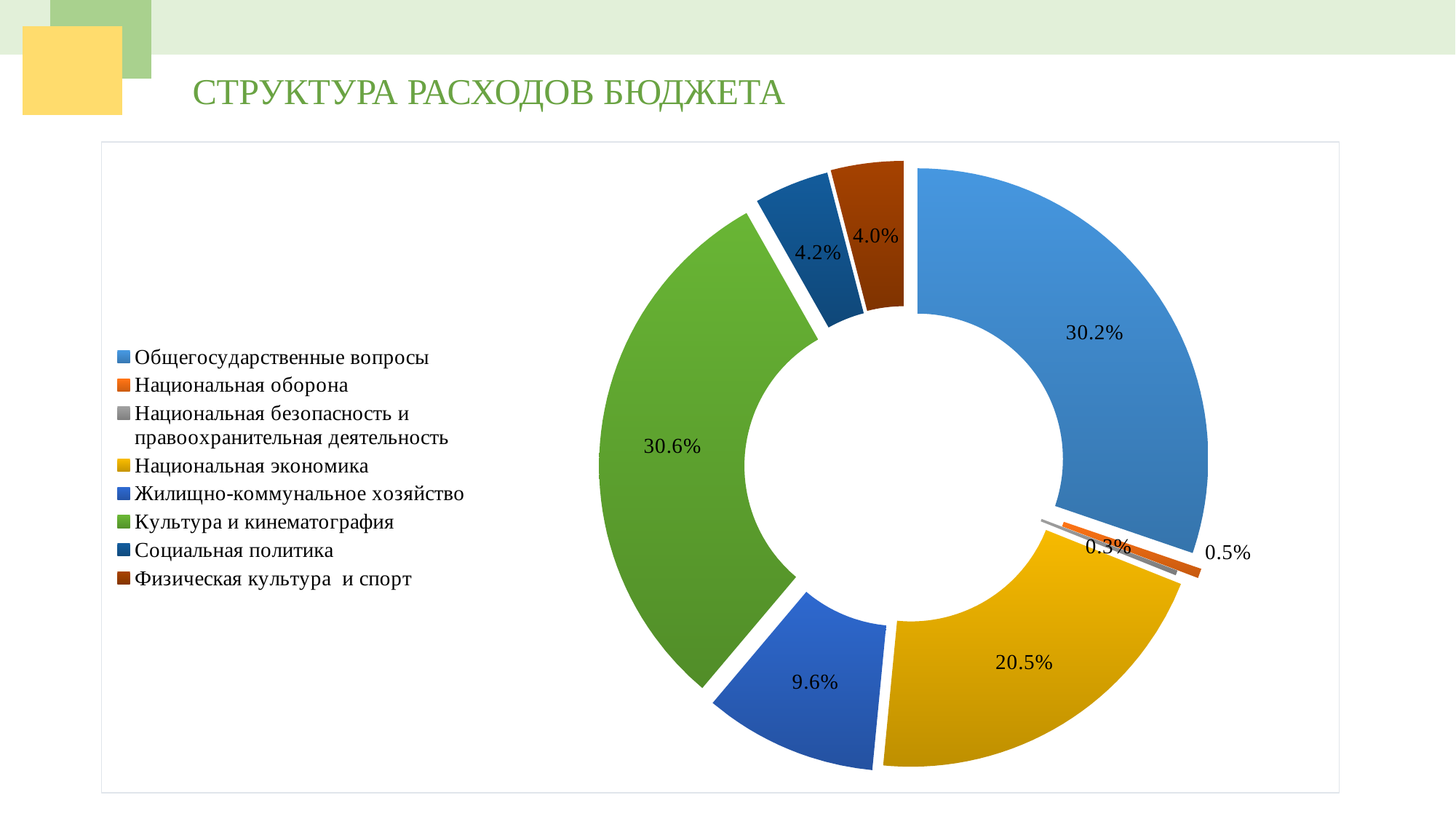
What share of budget expenditure goes to Жилищно-коммунальное хозяйство? 9.6% What share of budget expenditure goes to Национальная экономика? 20.5% What share of budget expenditure goes to Общегосударственные вопросы? 30.2% How many categories does the chart show? 8 What share of budget expenditure goes to Социальная политика? 4.2% Which category has the largest share of budget expenditure? Культура и кинематография What is the title of the slide? СТРУКТУРА РАСХОДОВ БЮДЖЕТА What share of budget expenditure goes to Физическая культура и спорт? 4.0% Which is larger: the share for Национальная оборона or the share for Национальная безопасность и правоохранительная деятельность? Национальная оборона What is the difference in percentage points between Культура и кинематография and Общегосударственные вопросы? 0.4 What kind of chart is shown on the slide? Doughnut (pie) chart Which category has the smallest share of budget expenditure? Национальная безопасность и правоохранительная деятельность